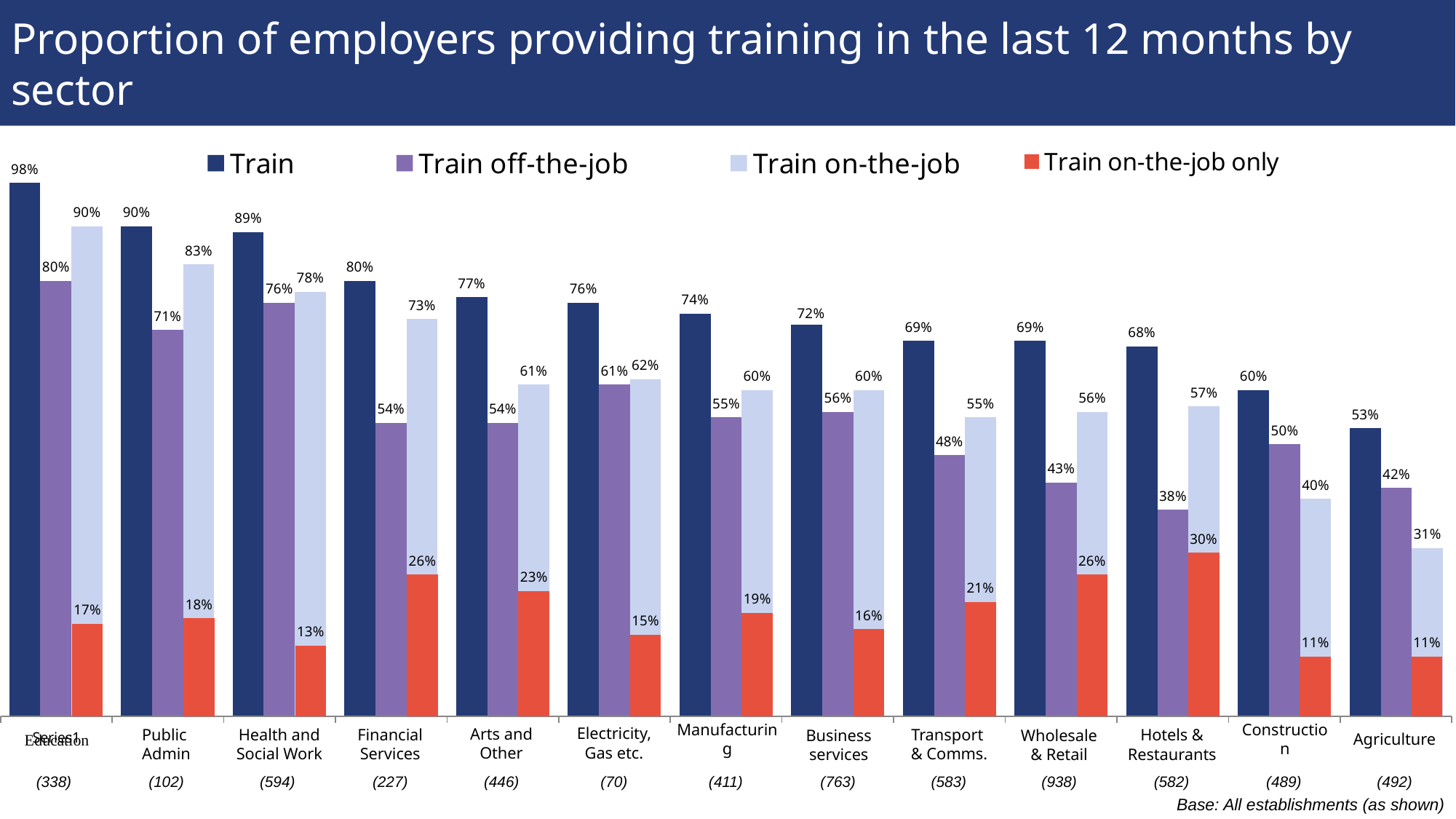
What is the 'Train on-the-job only' value for Hotels & Restaurants? 30% What type of chart is shown on the slide? Bar chart What is the difference between the 'Train' value and the 'Train on-the-job' value for Construction? 20% What is the 'Train' value for Manufacturing? 74% What is the 'Train off-the-job' value for Wholesale & Retail? 43% What is the base (number of establishments) shown for Business services? (763) How many series does the legend list? 4 How many sectors are shown on the x axis? 13 Which is larger for Financial Services: 'Train off-the-job' or 'Train on-the-job'? Train on-the-job Which sector has the lowest 'Train' value? Agriculture Which sector has the highest 'Train on-the-job only' value? Hotels & Restaurants Do the 'Train' values rise or fall moving from left to right across the sectors? Fall